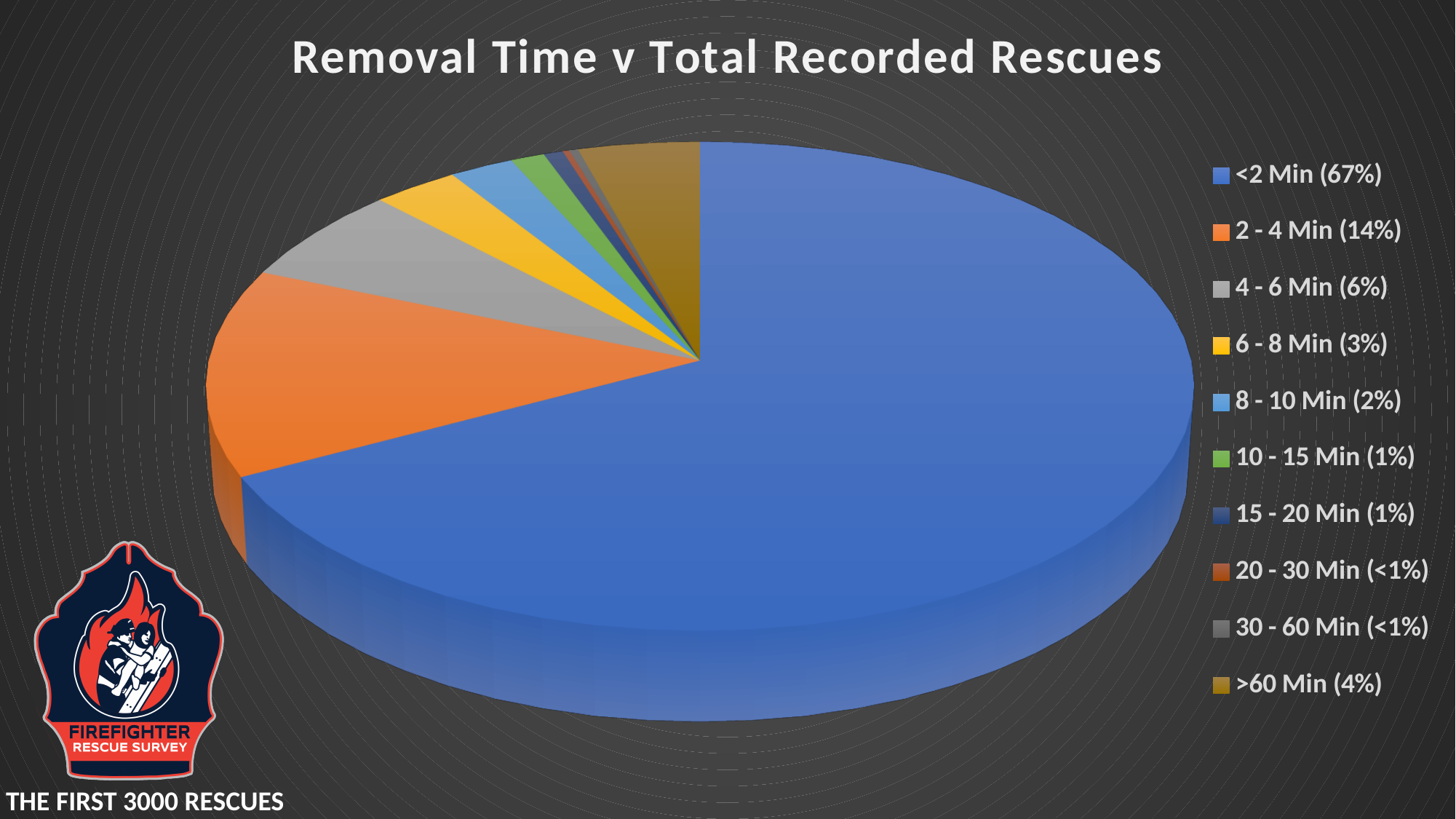
What share of rescues had a removal time of 6 - 8 Min? 3% What is the difference in percentage points between the <2 Min share and the 2 - 4 Min share? 53 What type of chart is shown on the slide? Pie chart Which removal time category has the largest share of rescues? <2 Min What share is shown for the 20 - 30 Min category? <1% What is the title of the chart? Removal Time v Total Recorded Rescues What share of rescues had a removal time of 2 - 4 Min? 14% What colour is the slice for the <2 Min category? Blue Which is larger, the share for 4 - 6 Min or the share for >60 Min? 4 - 6 Min How many removal time categories does the legend list? 10